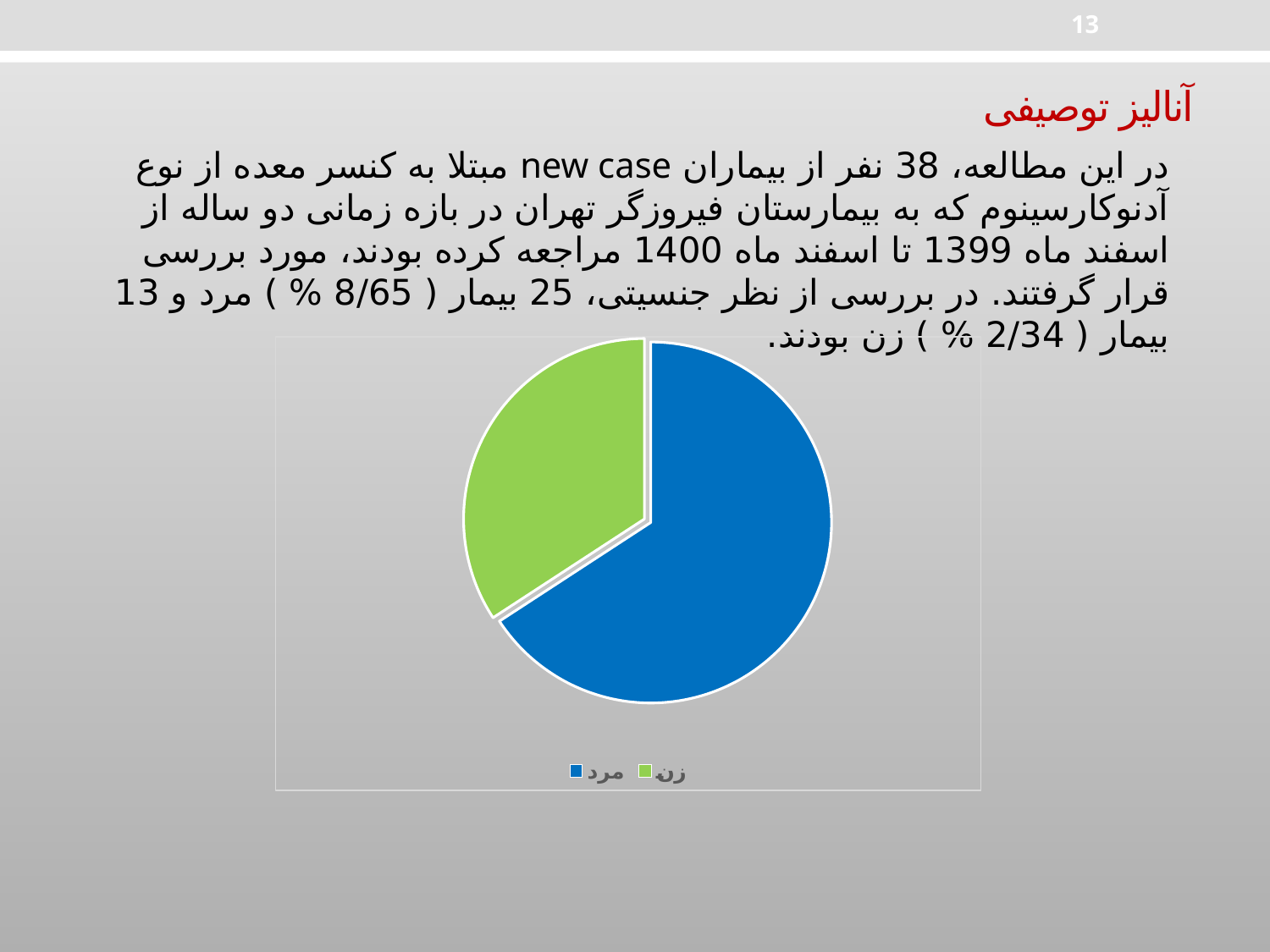
What kind of chart is shown on the slide? pie chart Which category has the largest slice in the pie chart? مرد What colour is the مرد slice in the pie chart? blue What colour is the زن slice in the pie chart? green Which slice is larger in the pie chart, مرد or زن? مرد How many entries does the legend of the pie chart list? 2 Which category has the smallest slice in the pie chart? زن How many slices does the pie chart have? 2